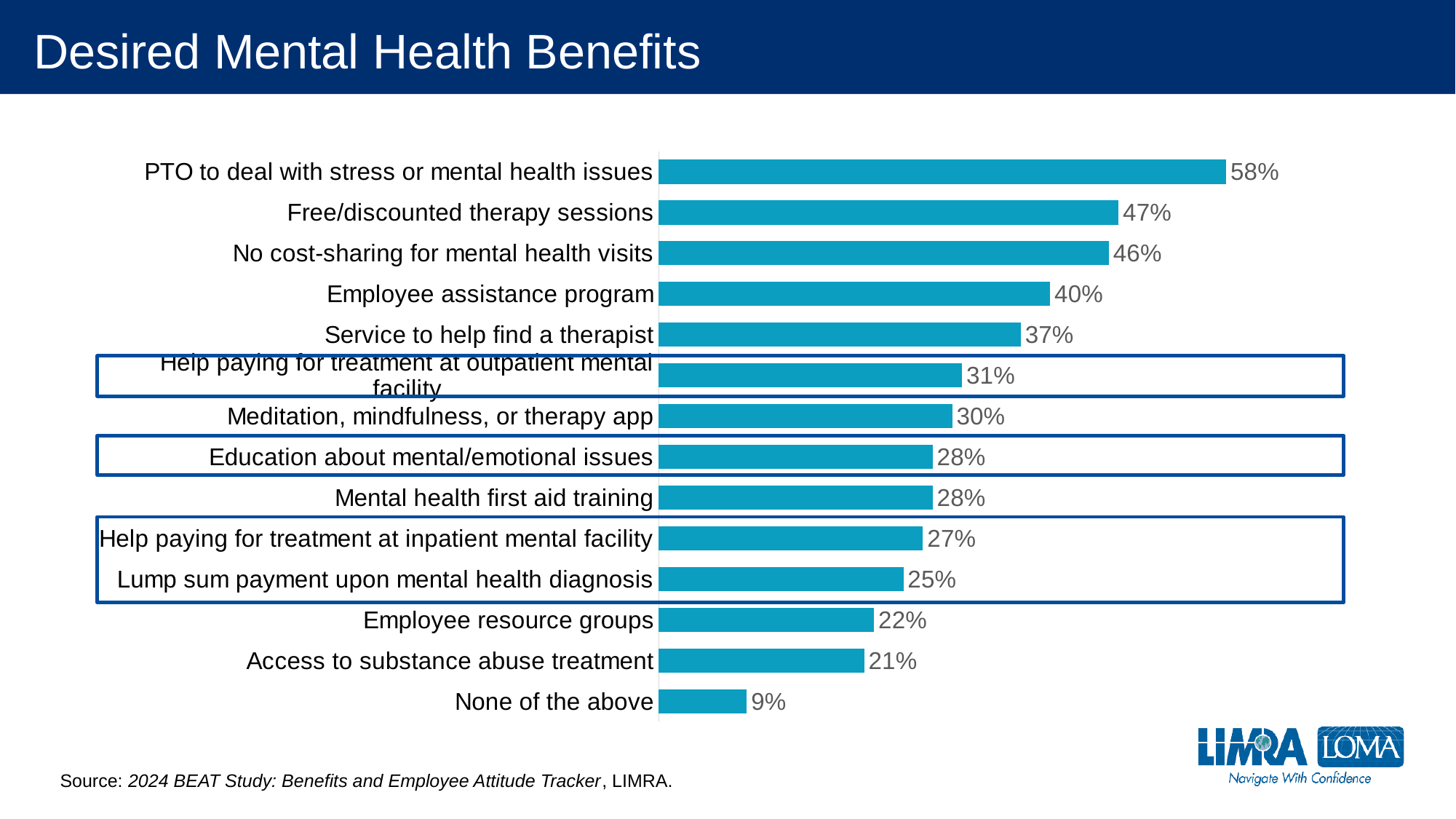
Which category has the lowest percentage? None of the above What is the difference between Free/discounted therapy sessions and Access to substance abuse treatment? 26% Which is larger: Service to help find a therapist or Meditation, mindfulness, or therapy app? Service to help find a therapist What is the value for Employee assistance program? 40% What is the difference between No cost-sharing for mental health visits and Employee resource groups? 24% What kind of chart is shown on the slide? Bar chart How many categories are shown in the chart? 14 Which benefit has the highest percentage? PTO to deal with stress or mental health issues What is the value for Lump sum payment upon mental health diagnosis? 25% What is the value for Help paying for treatment at inpatient mental facility? 27% What percentage of respondents desire PTO to deal with stress or mental health issues? 58% What is the title of the slide? Desired Mental Health Benefits